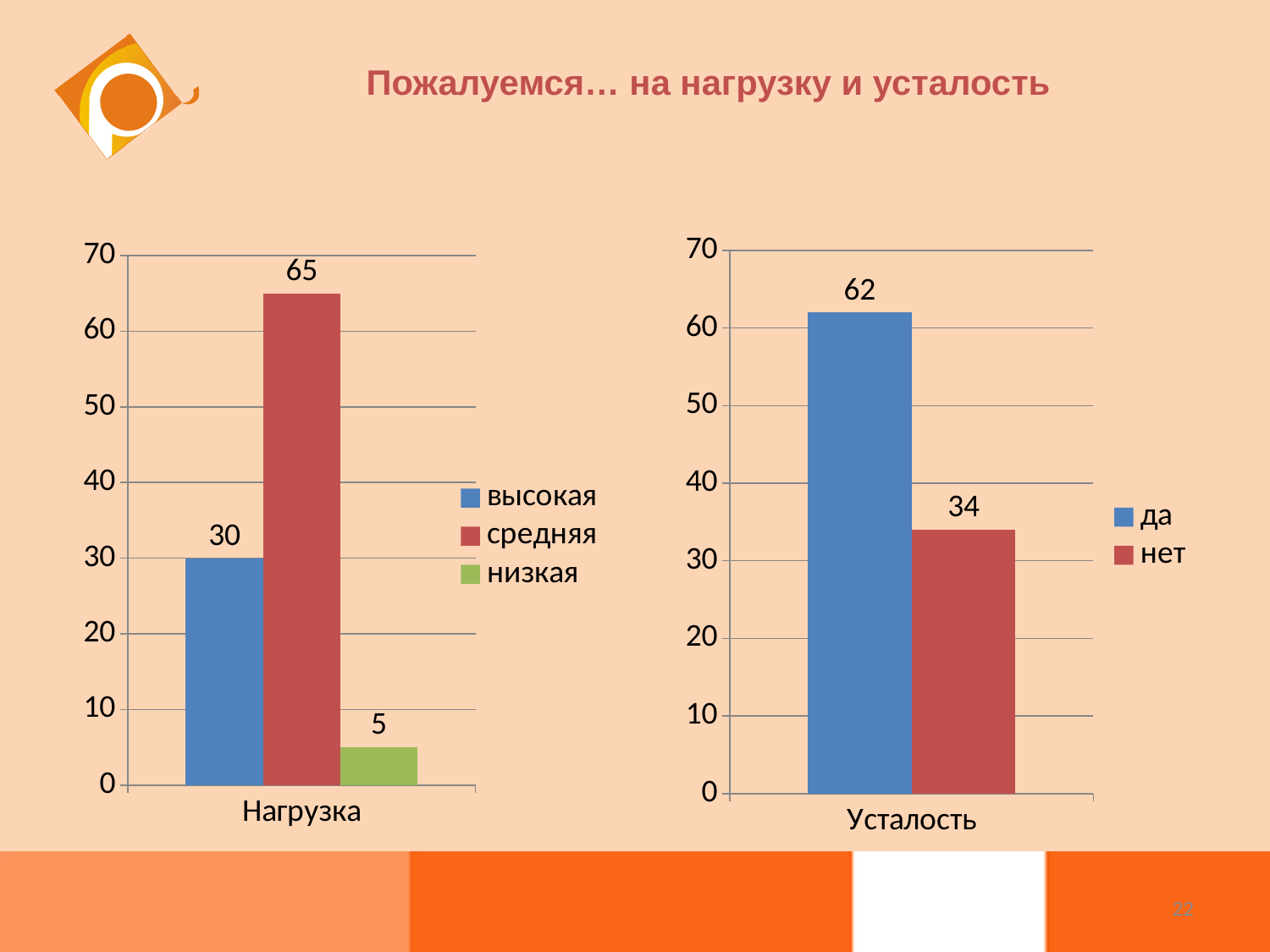
In the left chart (Нагрузка), what is the value for средняя? 65 In the right chart (Усталость), what is the value for нет? 34 In the left chart (Нагрузка), how many series does the legend list? 3 In the left chart (Нагрузка), what is the value for высокая? 30 In the right chart (Усталость), what is the value for да? 62 In the left chart (Нагрузка), which series has the highest value? средняя In the right chart (Усталость), which is larger, да or нет? да What kind of chart is the right chart (Усталость)? bar chart In the left chart (Нагрузка), what is the value for низкая? 5 In the left chart (Нагрузка), what is the difference between средняя and высокая? 35 In the right chart (Усталость), what is the difference between да and нет? 28 In the left chart (Нагрузка), which series has the lowest value? низкая